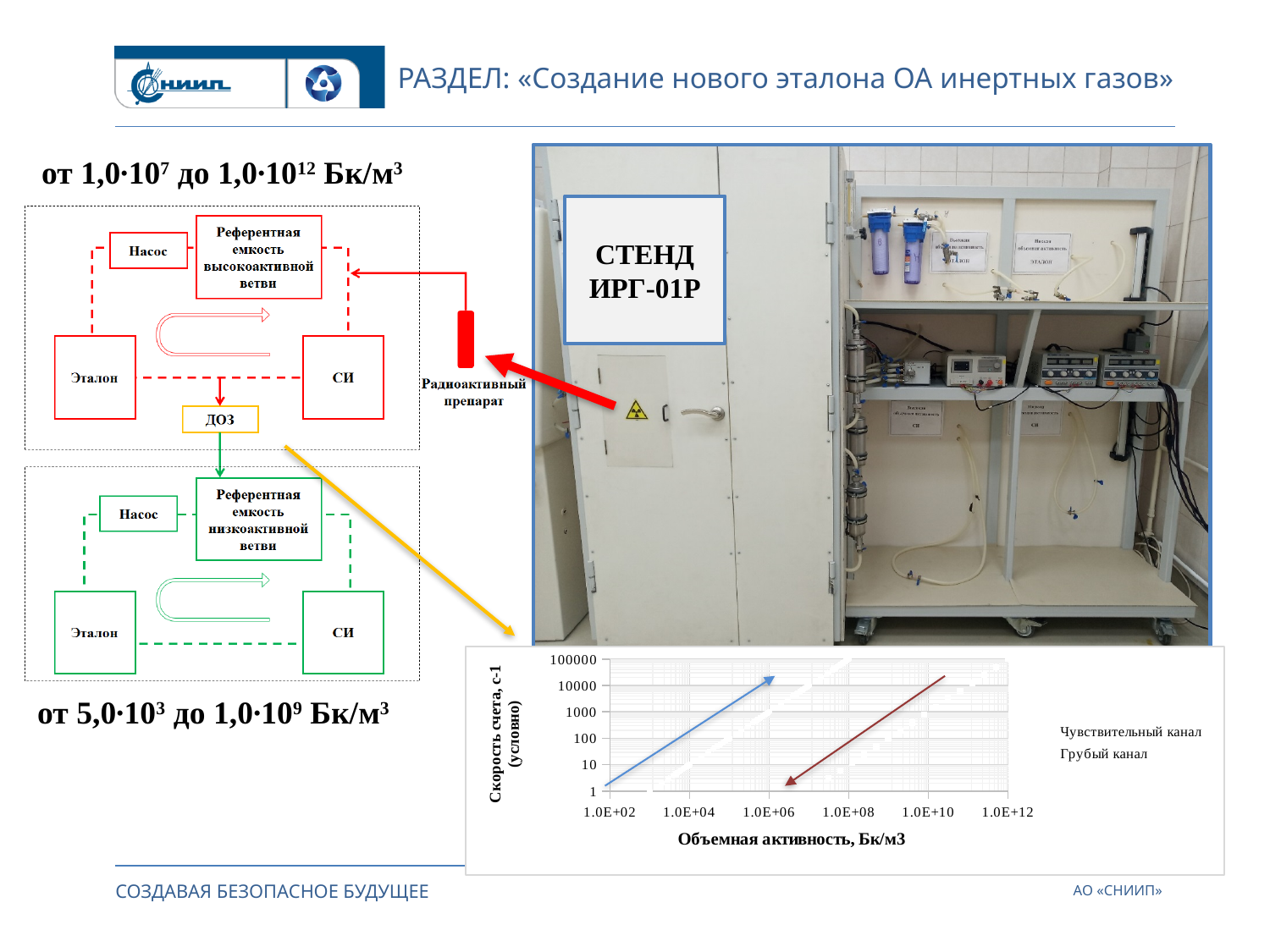
How many tick labels are shown on the x axis of the bottom-right chart? 6 In the bottom-right chart, which series extends to higher volumetric activity values, Чувствительный канал or Грубый канал? Грубый канал What is the lowest tick value shown on the x axis of the bottom-right chart? 1.0E+02 What is the highest tick value shown on the y axis of the bottom-right chart? 100000 What are the two series named in the legend of the bottom-right chart? Чувствительный канал, Грубый канал What kind of chart is shown at the bottom right of the slide? line chart How many series does the legend of the bottom-right chart list? 2 What is the highest tick value shown on the x axis of the bottom-right chart? 1.0E+12 What is the x-axis title of the bottom-right chart? Объемная активность, Бк/м3 In the bottom-right chart, does the count rate rise or fall as volumetric activity increases along the x axis? rise In the bottom-right chart, which series lies at lower volumetric activity values, Чувствительный канал or Грубый канал? Чувствительный канал